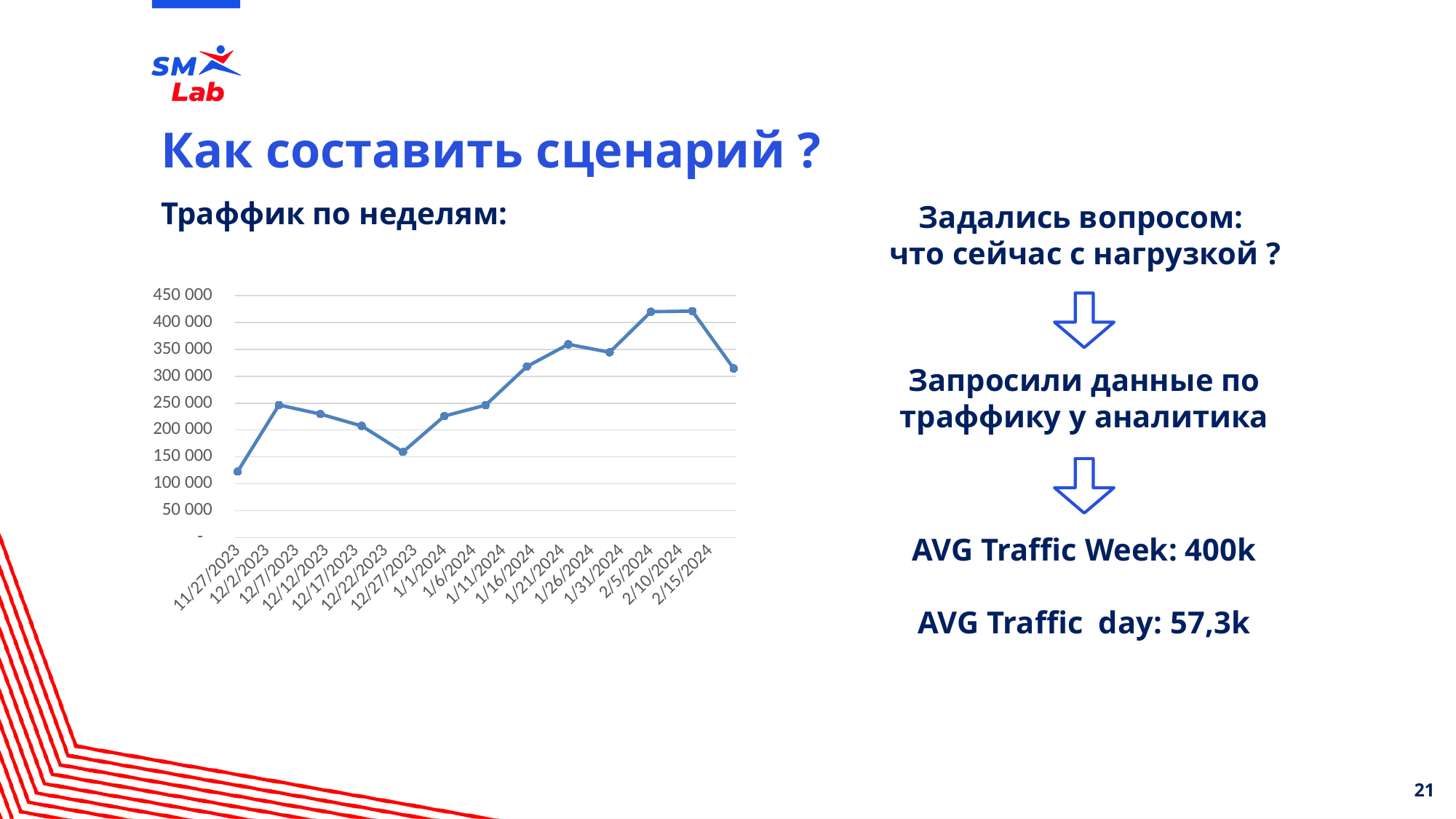
Is the last plotted value on the chart greater or less than the first plotted value? greater Is the highest plotted value on the chart greater or less than 400 000? greater Is the last plotted value on the chart greater or less than 250 000? greater What kind of chart is shown on the slide? line chart Is the first plotted value on the chart greater or less than 150 000? less What is the title above the chart? Траффик по неделям: What is the highest tick value shown on the vertical axis? 450 000 Does the traffic overall rise or fall from the start of the chart to its peak in February 2024? rise How many lines (series) are plotted on the chart? 1 How many data points are plotted on the line? 13